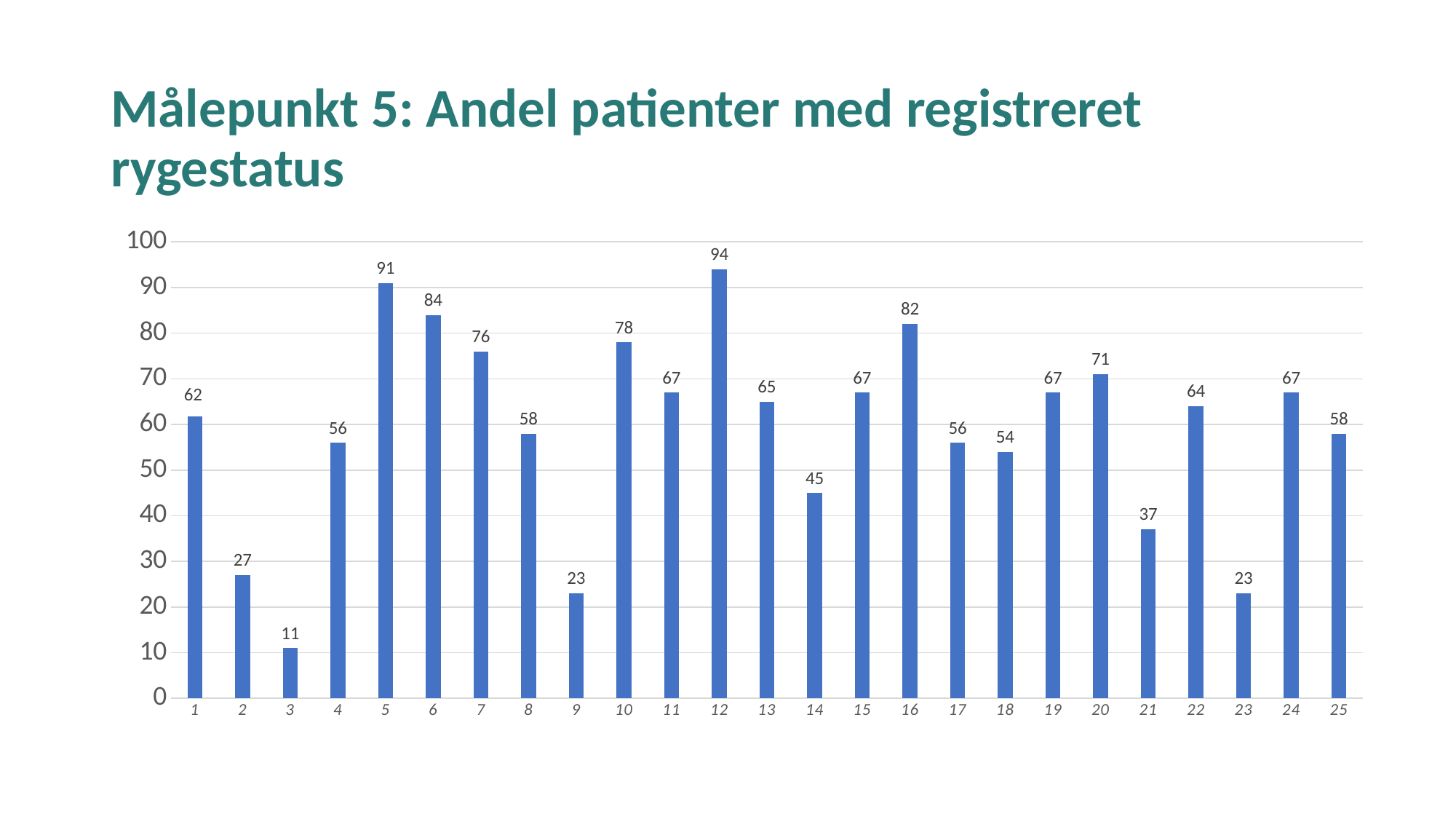
Which category has the highest value? 12 Which is larger, the value for category 16 or the value for category 20? Category 16 What is the difference between the values for category 12 and category 3? 83 What is the difference between the values for category 5 and category 4? 35 What is the value for category 3? 11 What is the title of the slide? Målepunkt 5: Andel patienter med registreret rygestatus Is the value for category 14 greater or less than 50? less What is the value for category 12? 94 How many categories are shown on the x axis? 25 What is the value for category 21? 37 Which category has the lowest value? 3 What kind of chart is shown on the slide? Bar chart